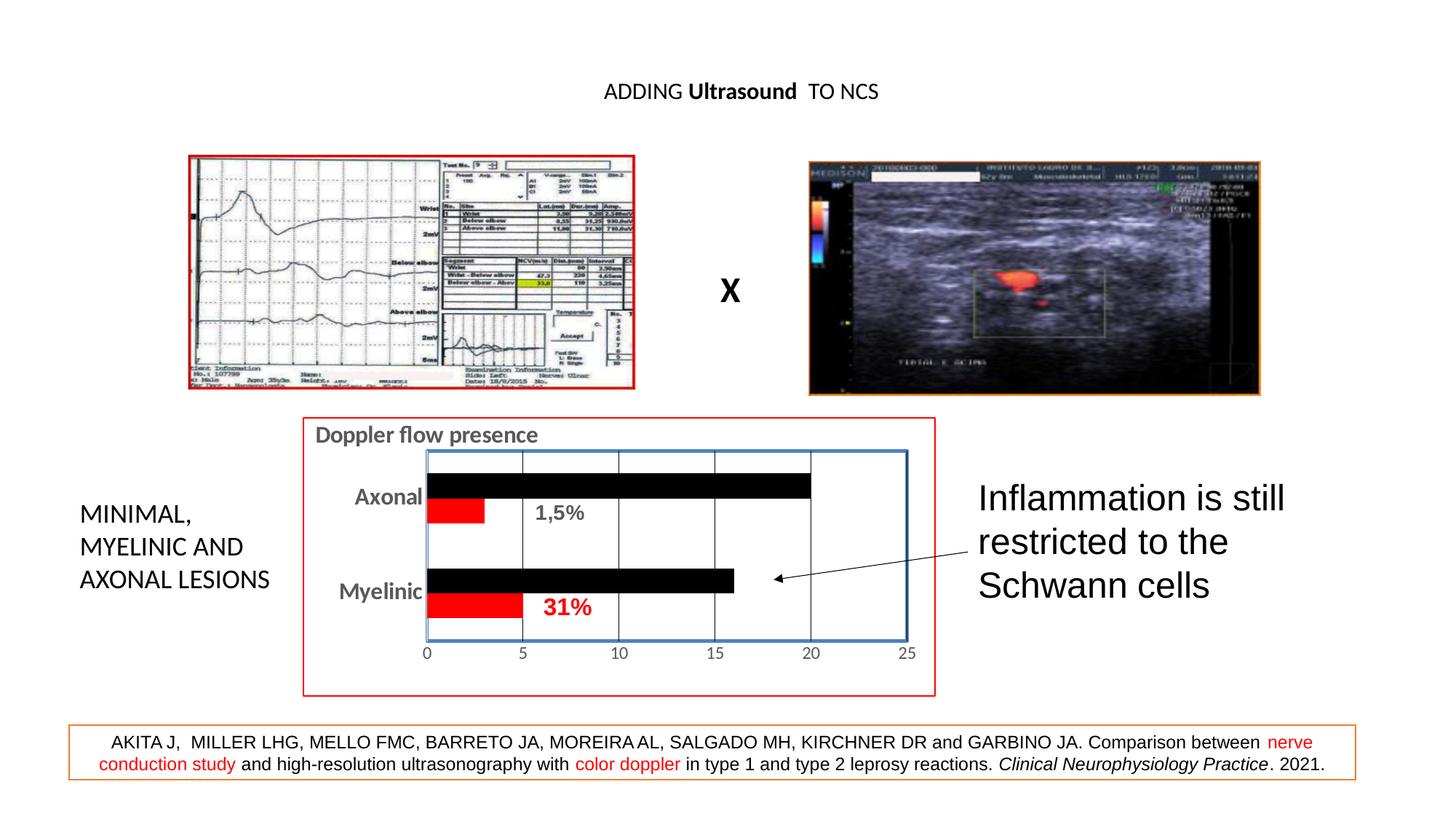
In the 'Doppler flow presence' chart, which category has the longer black bar, Axonal or Myelinic? Axonal What percentage label is printed next to the Axonal bars in the 'Doppler flow presence' chart? 1,5% In the 'Doppler flow presence' chart, is the red bar for Axonal greater or less than 5? less What is the title of the chart on the slide? Doppler flow presence In the 'Doppler flow presence' chart, is the black bar for Axonal greater or less than 15? greater What percentage label is printed next to the Myelinic bars in the 'Doppler flow presence' chart? 31% How many categories are shown on the y axis of the 'Doppler flow presence' chart? 2 In the 'Doppler flow presence' chart, is the black bar for Myelinic greater or less than 20? less What kind of chart is shown under the title 'Doppler flow presence'? bar chart What is the highest value shown on the x axis of the 'Doppler flow presence' chart? 25 In the 'Doppler flow presence' chart, which category has the longer red bar, Axonal or Myelinic? Myelinic